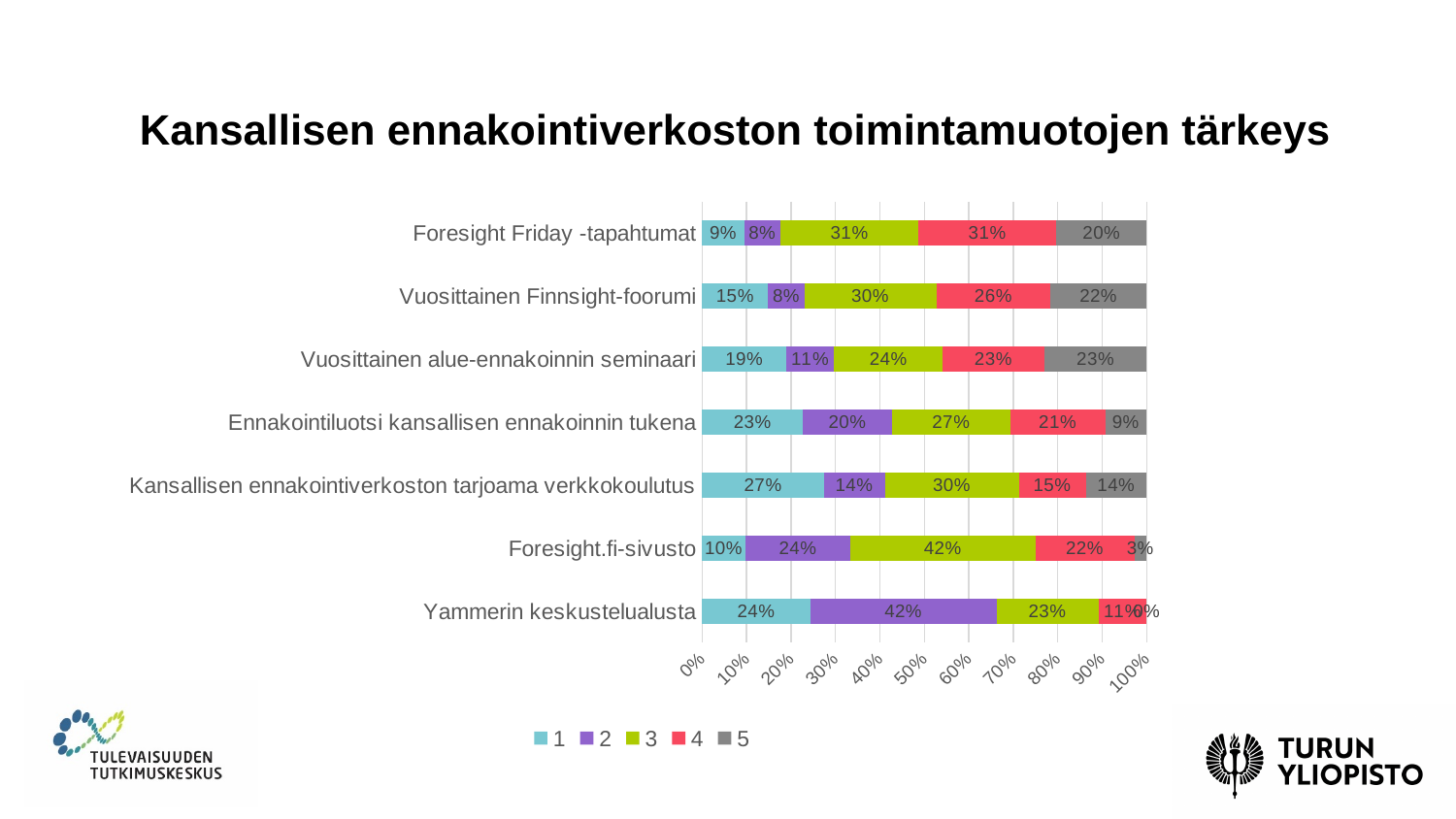
Which category has the highest value for series 1? Kansallisen ennakointiverkoston tarjoama verkkokoulutus What kind of chart is shown on the slide? Stacked bar chart What is the value of series 4 for Foresight Friday -tapahtumat? 31% Which category has the lowest value for series 5? Yammerin keskustelualusta What is the title of the chart? Kansallisen ennakointiverkoston toimintamuotojen tärkeys How many categories (activity types) are shown on the chart? 7 Which is larger: the series 4 value for Vuosittainen Finnsight-foorumi or for Vuosittainen alue-ennakoinnin seminaari? Vuosittainen Finnsight-foorumi What is the value of series 1 for Kansallisen ennakointiverkoston tarjoama verkkokoulutus? 27% How many series does the legend list? 5 What is the difference between the series 2 values for Yammerin keskustelualusta and Foresight.fi-sivusto? 18% What is the value of series 5 for Ennakointiluotsi kansallisen ennakoinnin tukena? 9% What is the value of series 3 for Foresight.fi-sivusto? 42%